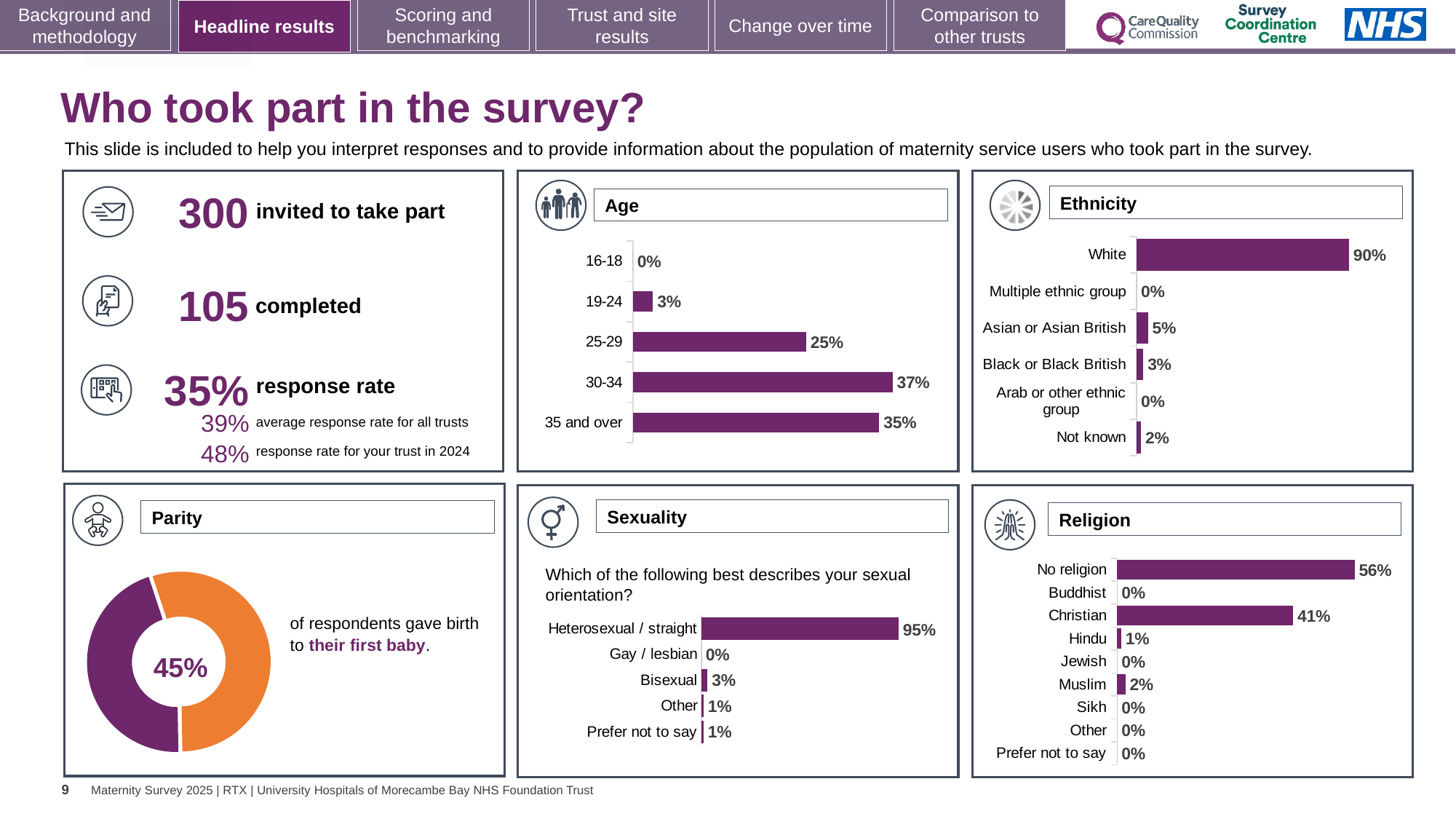
In the Religion chart, what is the difference between No religion and Christian? 15% What kind of chart is the Parity chart? Doughnut chart In the Parity chart, what percentage of respondents gave birth to their first baby? 45% In the Ethnicity chart, what percentage of respondents were White? 90% In the Religion chart, what percentage of respondents answered Christian? 41% In the Sexuality chart, what percentage of respondents answered Heterosexual / straight? 95% In the Age chart, what is the difference between the 30-34 and 25-29 percentages? 12% In the Ethnicity chart, which is larger: Asian or Asian British, or Black or Black British? Asian or Asian British In the Age chart, what percentage of respondents were aged 30-34? 37% How many categories does the Ethnicity chart show? 6 In the Age chart, which age group has the highest percentage? 30-34 In the Religion chart, which category has the highest percentage? No religion